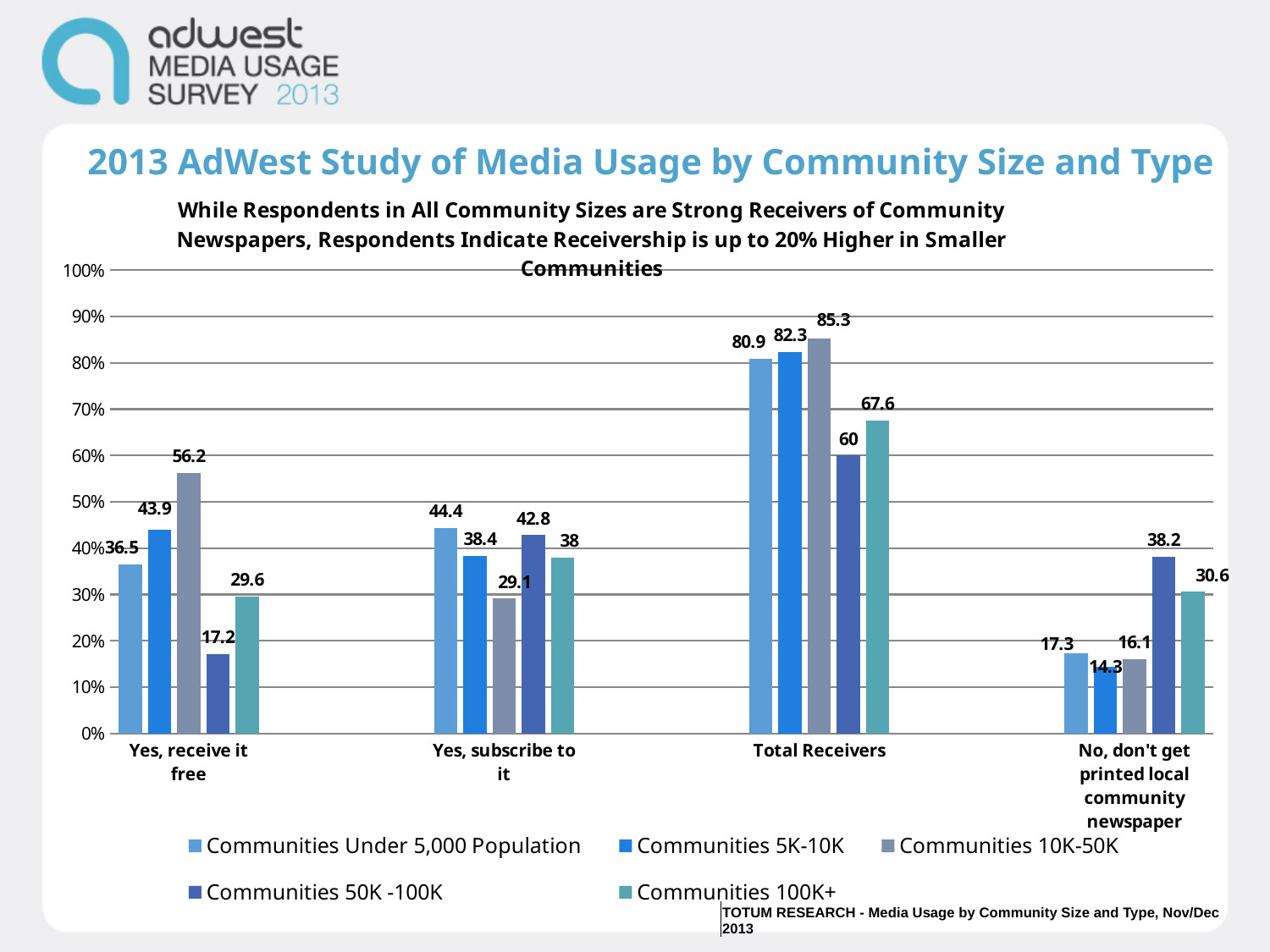
Which community size series has the highest value in the "Total Receivers" category? Communities 10K-50K What is the difference between the Communities 10K-50K and Communities 50K -100K values in the "Total Receivers" category? 25.3 Which community size series has the lowest value in the "Yes, receive it free" category? Communities 50K -100K Is the value for Communities 100K+ in the "Total Receivers" category greater or less than 70%? less How many series does the chart legend list? 5 In the "Yes, subscribe to it" category, which is larger: the value for Communities Under 5,000 Population or for Communities 10K-50K? Communities Under 5,000 Population What is the highest value shown on the chart's y axis? 100% What type of chart is shown on the slide? Bar chart What is the value for Communities 5K-10K in the "No, don't get printed local community newspaper" category? 14.3 What is the value for Communities 50K -100K in the "Total Receivers" category? 60 What is the value for Communities 10K-50K in the "Yes, receive it free" category? 56.2 How many categories are shown on the x axis of the chart? 4